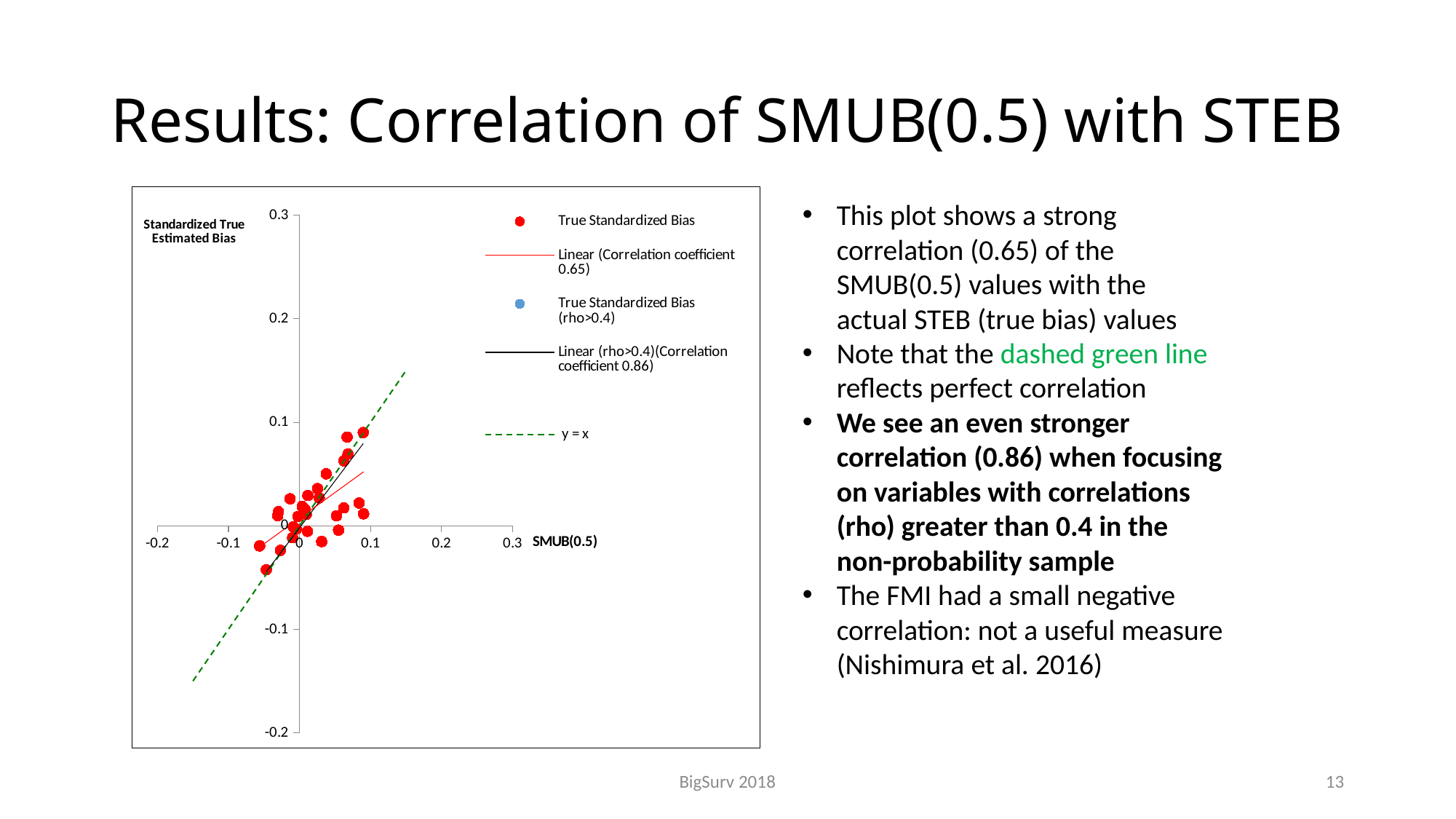
Is the highest plotted point's Standardized True Estimated Bias greater or less than 0.2? less Do the plotted points generally rise or fall as SMUB(0.5) increases along the x axis? Rise What kind of chart is shown on the slide? Scatter chart Is the lowest plotted point's Standardized True Estimated Bias greater or less than -0.1? greater Which fitted line is steeper, the red line (all points) or the black line (rho>0.4)? The black line (rho>0.4) What is the label on the x axis of the chart? SMUB(0.5) What does the dashed green line in the chart represent, according to the legend? y = x According to the legend, what is the correlation coefficient of the red linear fit line? 0.65 How many entries does the chart legend list? 5 According to the legend, what is the correlation coefficient of the black linear fit line for rho>0.4? 0.86 Is the largest SMUB(0.5) value among the plotted points greater or less than 0.2? less